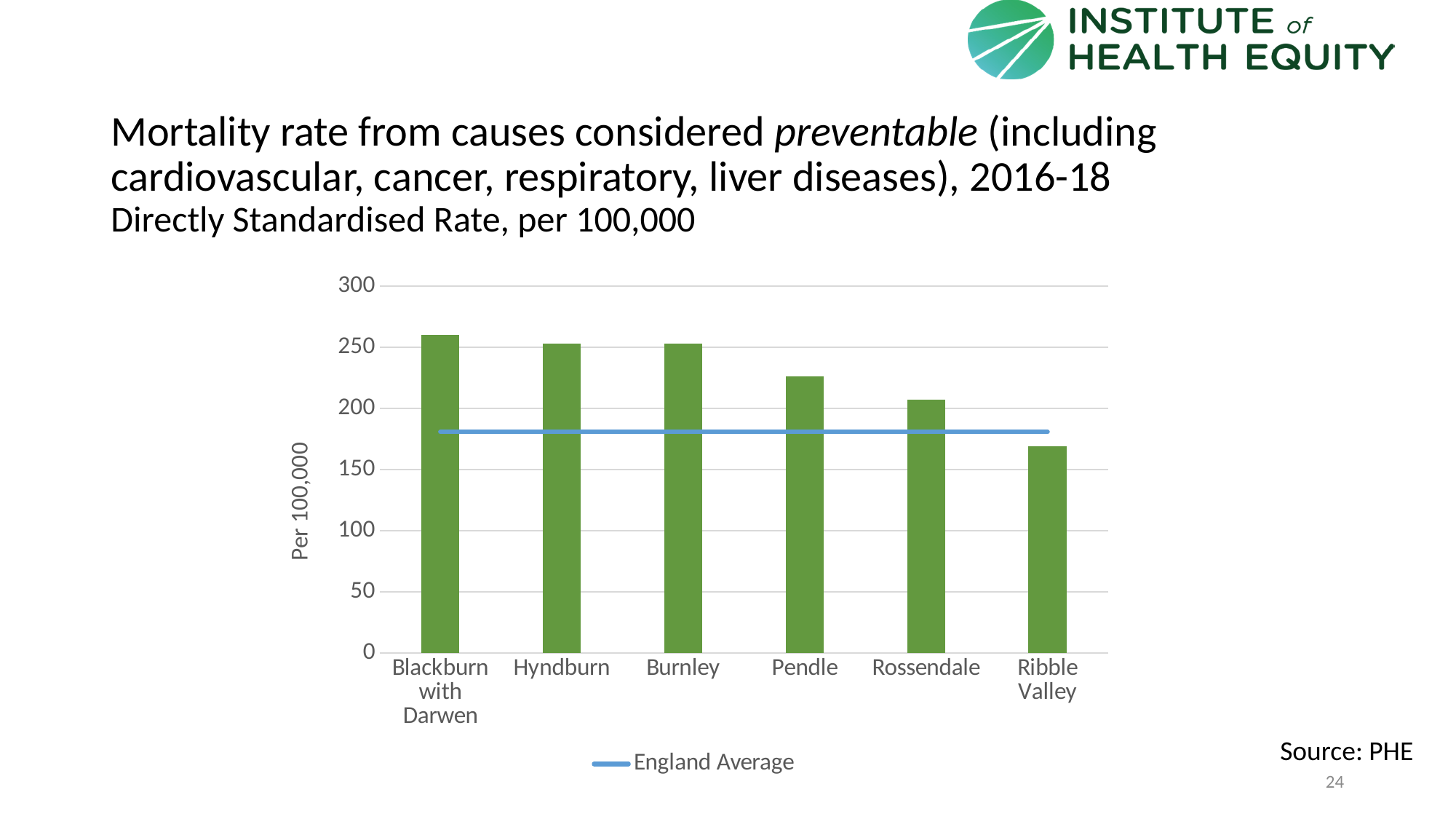
Which area has the lowest preventable mortality rate in the chart? Ribble Valley Is the value for Ribble Valley greater or less than 200? less Which area has the highest preventable mortality rate in the chart? Blackburn with Darwen How many entries does the chart legend list? 1 What does the horizontal blue line on the chart represent, according to the legend? England Average Is the value for Blackburn with Darwen greater or less than 250? greater Which has the higher preventable mortality rate, Pendle or Rossendale? Pendle Is the value for Pendle greater or less than 200? greater How many local areas are shown on the x axis of the chart? 6 Do the bar values generally rise or fall moving from left to right along the x axis? fall What kind of chart is shown on the slide? bar chart